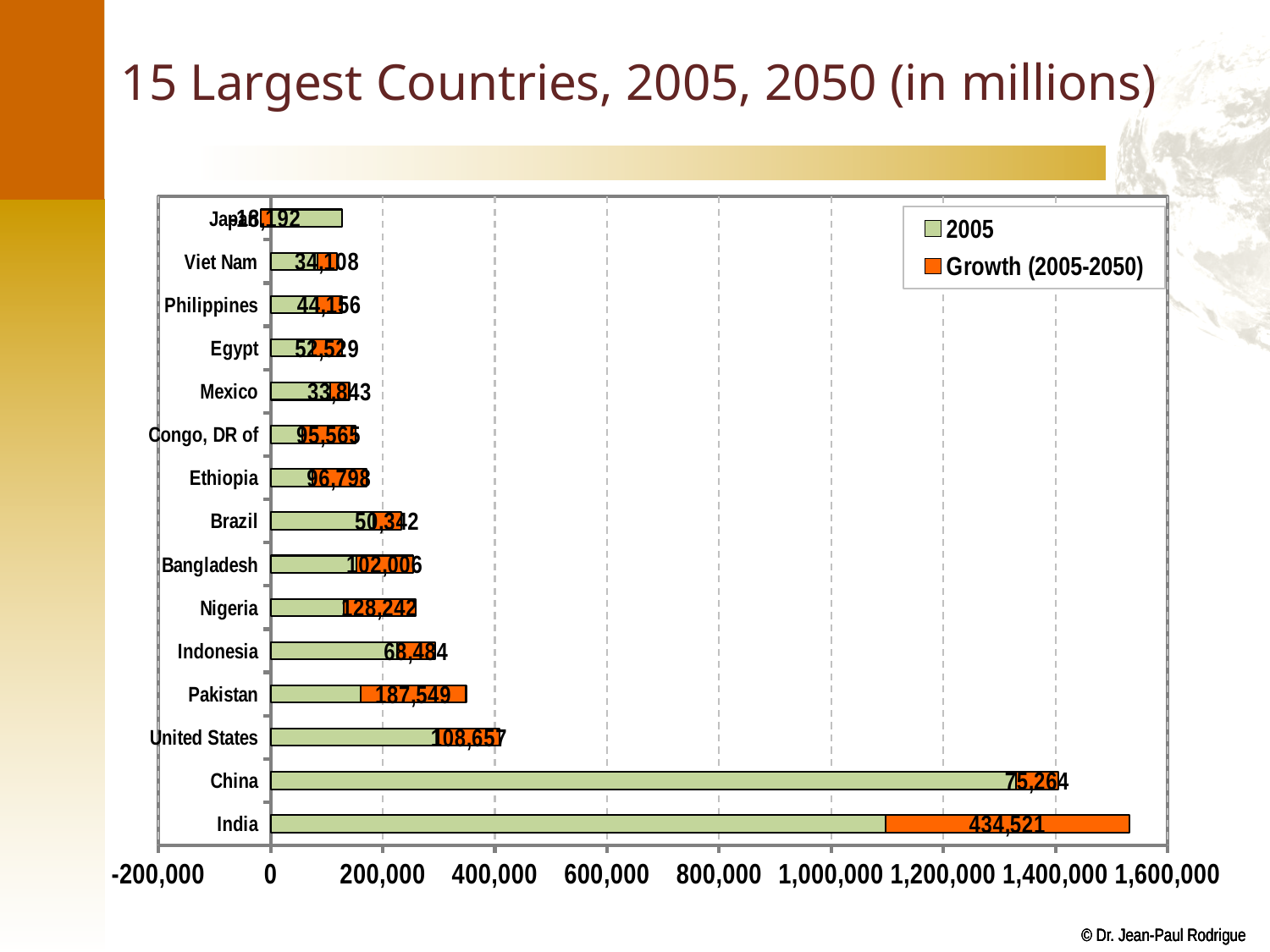
Is the 2005 value for China greater or less than 1,200,000? greater What is the Growth (2005-2050) value labelled for the United States? 108,657 Which has the larger Growth (2005-2050) value, Pakistan or the United States? Pakistan Which country has the longest total bar on the chart? India What are the two series named in the legend? 2005 and Growth (2005-2050) What is the Growth (2005-2050) value labelled for Pakistan? 187,549 How many series does the legend list? 2 Which country has the largest Growth (2005-2050) value? India What kind of chart is shown on the slide? bar chart What is the difference between the Growth (2005-2050) values for India and Pakistan? 246,972 How many countries are listed on the chart? 15 What is the Growth (2005-2050) value labelled for India? 434,521